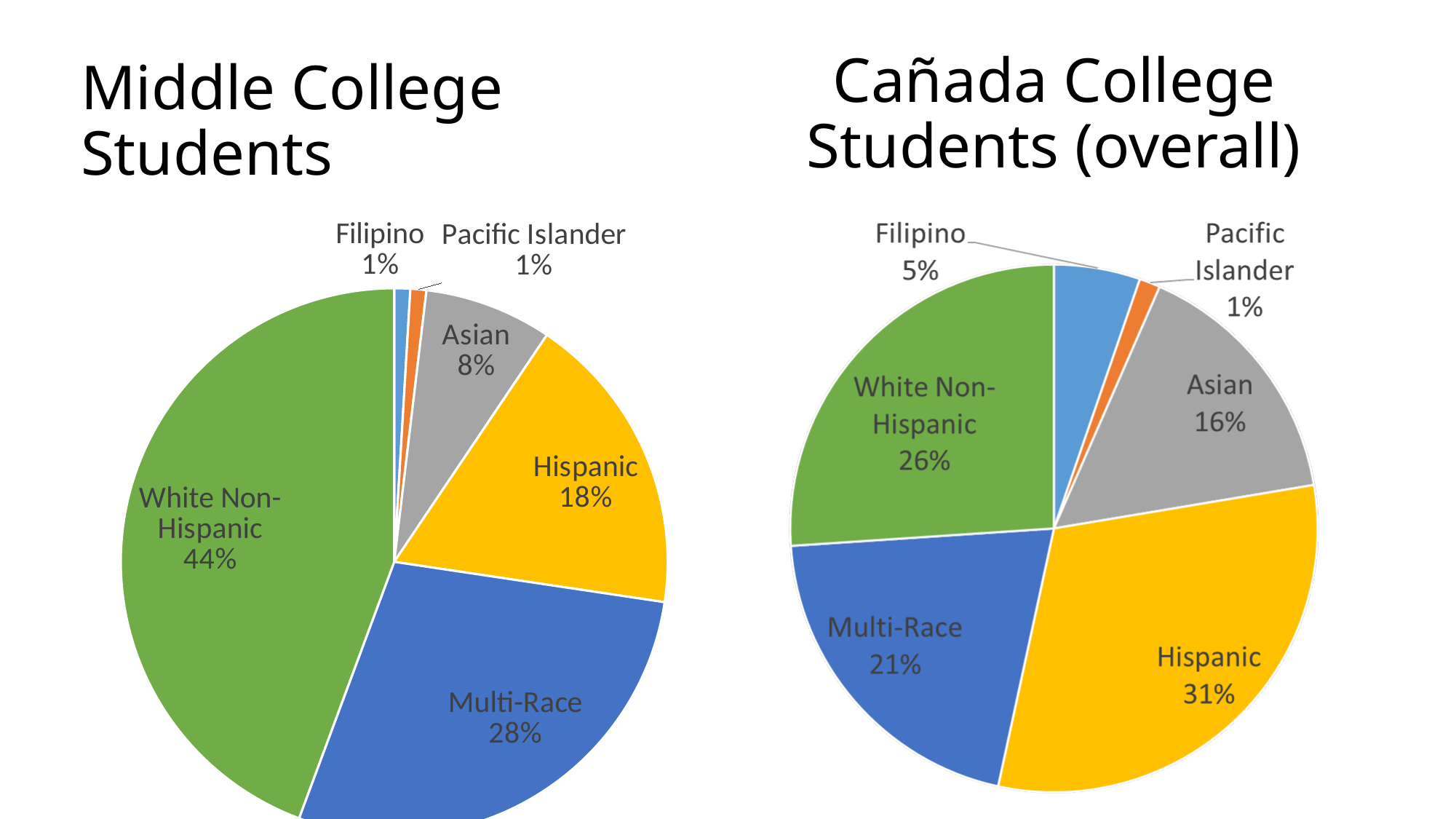
In the Cañada College Students (overall) chart, which category has the smallest slice? Pacific Islander In the Middle College Students chart, what is the difference between the Multi-Race and Hispanic shares? 10% What type of chart is the Cañada College Students (overall) chart? Pie chart In the Cañada College Students (overall) chart, which category has the largest slice? Hispanic In the Cañada College Students (overall) chart, what is the difference between the White Non-Hispanic and Multi-Race shares? 5% In the Cañada College Students (overall) chart, what share of students are Hispanic? 31% In the Middle College Students chart, what percentage is shown for Asian? 8% In the Cañada College Students (overall) chart, what percentage is shown for Filipino? 5% Which chart shows a larger Asian share, Middle College Students or Cañada College Students (overall)? Cañada College Students (overall) How many categories are shown in the Middle College Students chart? 6 In the Middle College Students chart, what share of students are White Non-Hispanic? 44% In the Middle College Students chart, which category has the largest slice? White Non-Hispanic